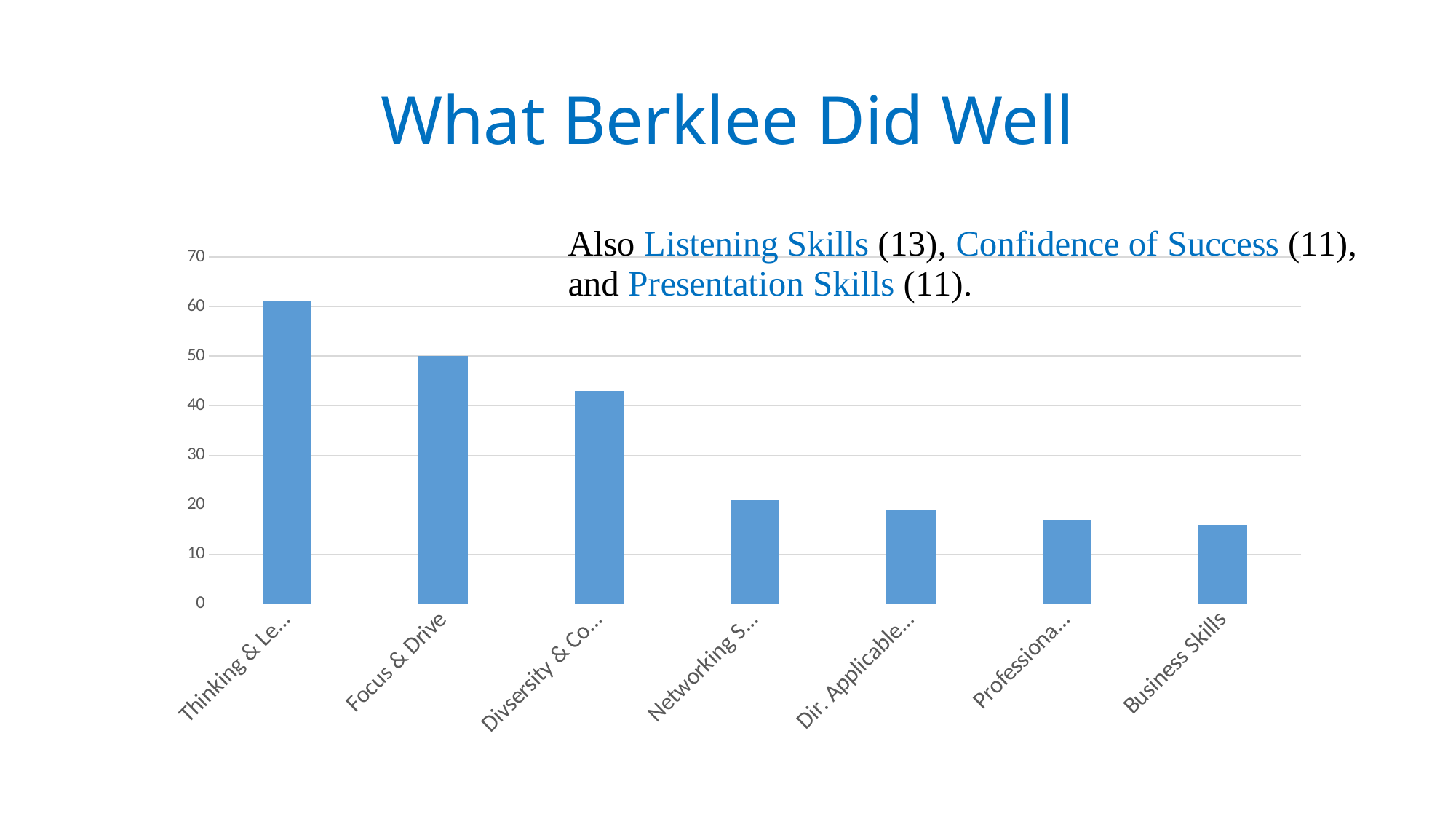
Which is larger, the value for Focus & Drive or the value for Business Skills? Focus & Drive Is the value for Focus & Drive greater or less than 40? greater Is the value for Thinking & Le... greater or less than 50? greater Is the value for Diversity & Co... greater or less than 40? greater Which category has the highest value in the chart? Thinking & Le... What is the value for Focus & Drive? 50 What is the title of the slide containing the chart? What Berklee Did Well Do the bar values rise or fall from left to right across the chart? fall How many categories (bars) does the chart show? 7 What kind of chart is shown on the slide? bar chart